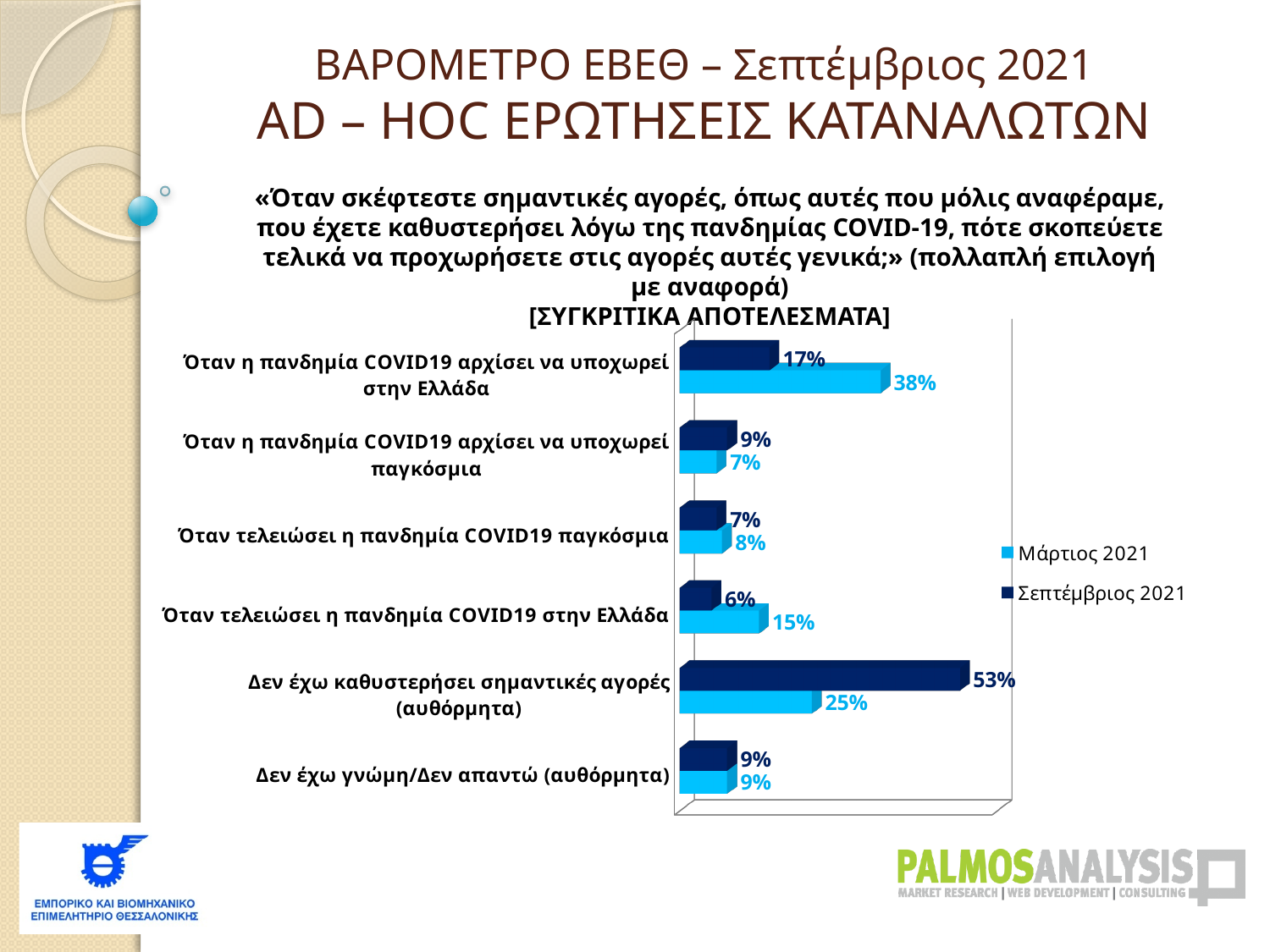
How many categories are shown in the chart? 6 What is the value for Μάρτιος 2021 for 'Όταν η πανδημία COVID19 αρχίσει να υποχωρεί στην Ελλάδα'? 38% Which category has the lowest value for Σεπτέμβριος 2021? Όταν τελειώσει η πανδημία COVID19 στην Ελλάδα What is the difference between the Σεπτέμβριος 2021 and Μάρτιος 2021 values for 'Δεν έχω καθυστερήσει σημαντικές αγορές (αυθόρμητα)'? 28% What kind of chart is shown on the slide? Bar chart What is the difference between the Μάρτιος 2021 and Σεπτέμβριος 2021 values for 'Όταν η πανδημία COVID19 αρχίσει να υποχωρεί στην Ελλάδα'? 21% Which category has the highest value for Σεπτέμβριος 2021? Δεν έχω καθυστερήσει σημαντικές αγορές (αυθόρμητα) For 'Δεν έχω καθυστερήσει σημαντικές αγορές (αυθόρμητα)', which series has the larger value, Μάρτιος 2021 or Σεπτέμβριος 2021? Σεπτέμβριος 2021 What is the value for Σεπτέμβριος 2021 for 'Δεν έχω καθυστερήσει σημαντικές αγορές (αυθόρμητα)'? 53% What is the value for Μάρτιος 2021 for 'Όταν τελειώσει η πανδημία COVID19 στην Ελλάδα'? 15% How many series does the legend list? 2 Which colour represents the Μάρτιος 2021 series in the legend? Light blue